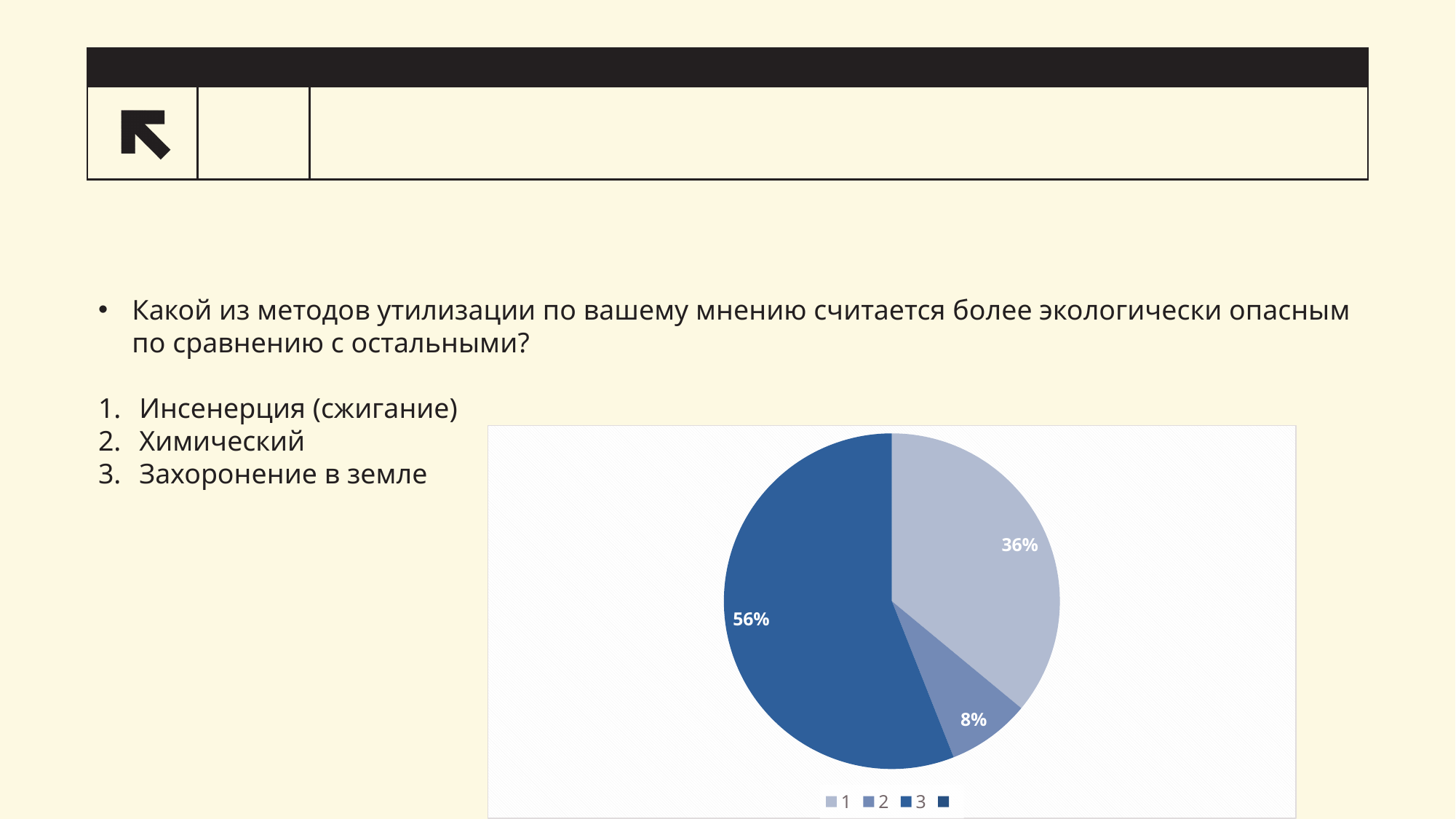
What share of the pie does category 1 have? 36% What kind of chart is shown on the slide? pie chart Which is larger, the slice for category 1 or the slice for category 2? 1 Which category has the largest slice of the pie? 3 Which category's slice is the darkest blue in the pie chart? 3 Is the slice for category 3 more or less than half of the pie? more What is the difference in percentage points between the slices for category 1 and category 2? 28 How many slices with data labels are shown in the pie chart? 3 Which category has the smallest slice of the pie? 2 What is the difference in percentage points between the slices for category 3 and category 1? 20 What share of the pie does category 2 have? 8% What share of the pie does category 3 have? 56%